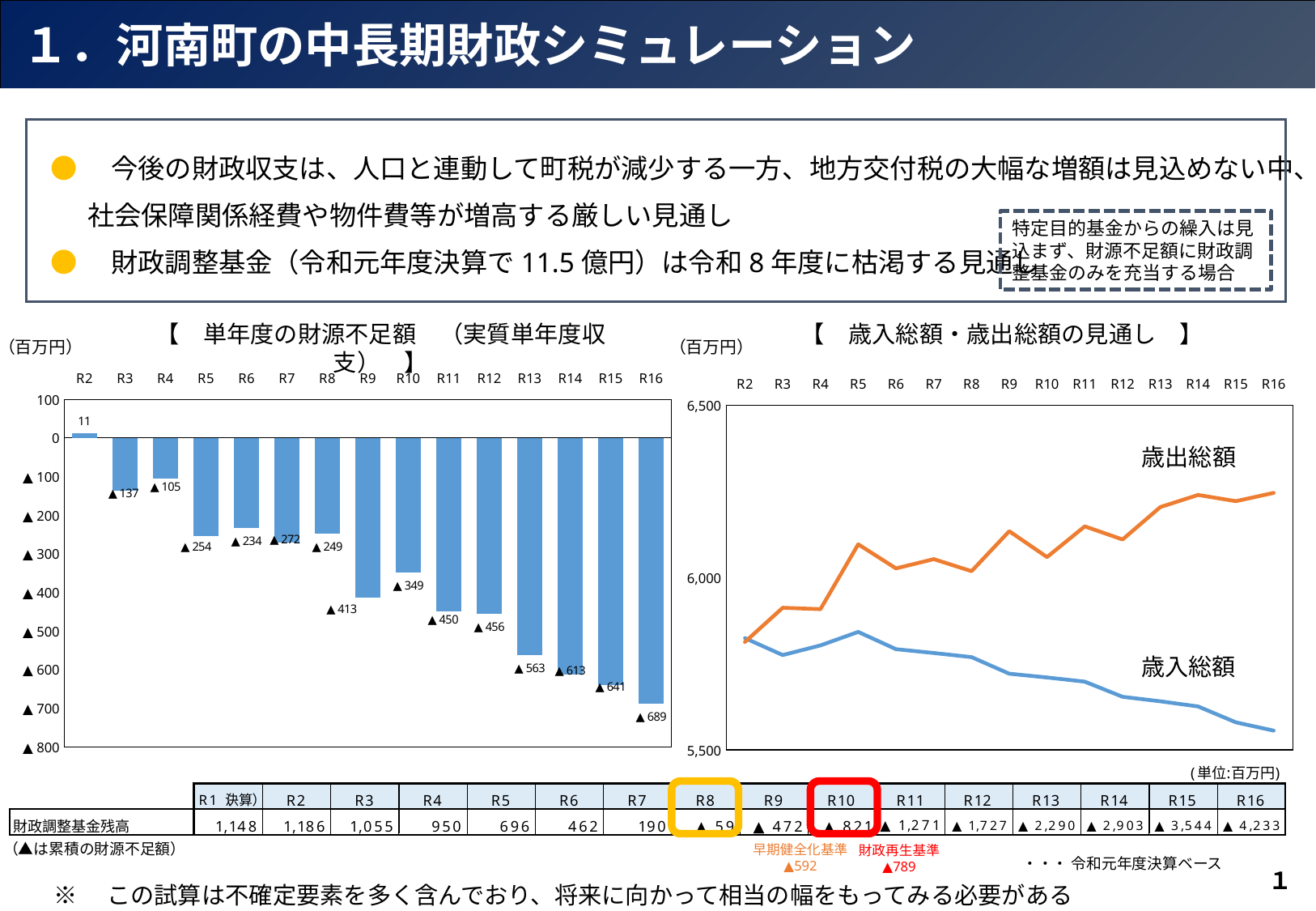
How many years (bars) are shown in the left chart (単年度の財源不足額)? 15 In the right chart (歳入総額・歳出総額の見通し), does 歳入総額 rise or fall from R5 to R16? Fall In the left chart (単年度の財源不足額), which has the larger deficit, R5 or R6? R5 In the left chart (単年度の財源不足額), what is the value for R16? ▲689 What kind of chart is the right chart (歳入総額・歳出総額の見通し)? Line chart In the left chart (単年度の財源不足額), which year has the largest deficit (the lowest bar)? R16 In the right chart (歳入総額・歳出総額の見通し), is the value of 歳出総額 for R16 greater or less than 6,000? greater In the left chart (単年度の財源不足額), which year is the only one with a positive value? R2 In the left chart (単年度の財源不足額), what is the value for R9? ▲413 In the left chart (単年度の財源不足額), what is the value for R2? 11 What kind of chart is the left chart (単年度の財源不足額)? Bar chart In the left chart (単年度の財源不足額), what is the difference between the values for R15 (▲641) and R14 (▲613)? 28